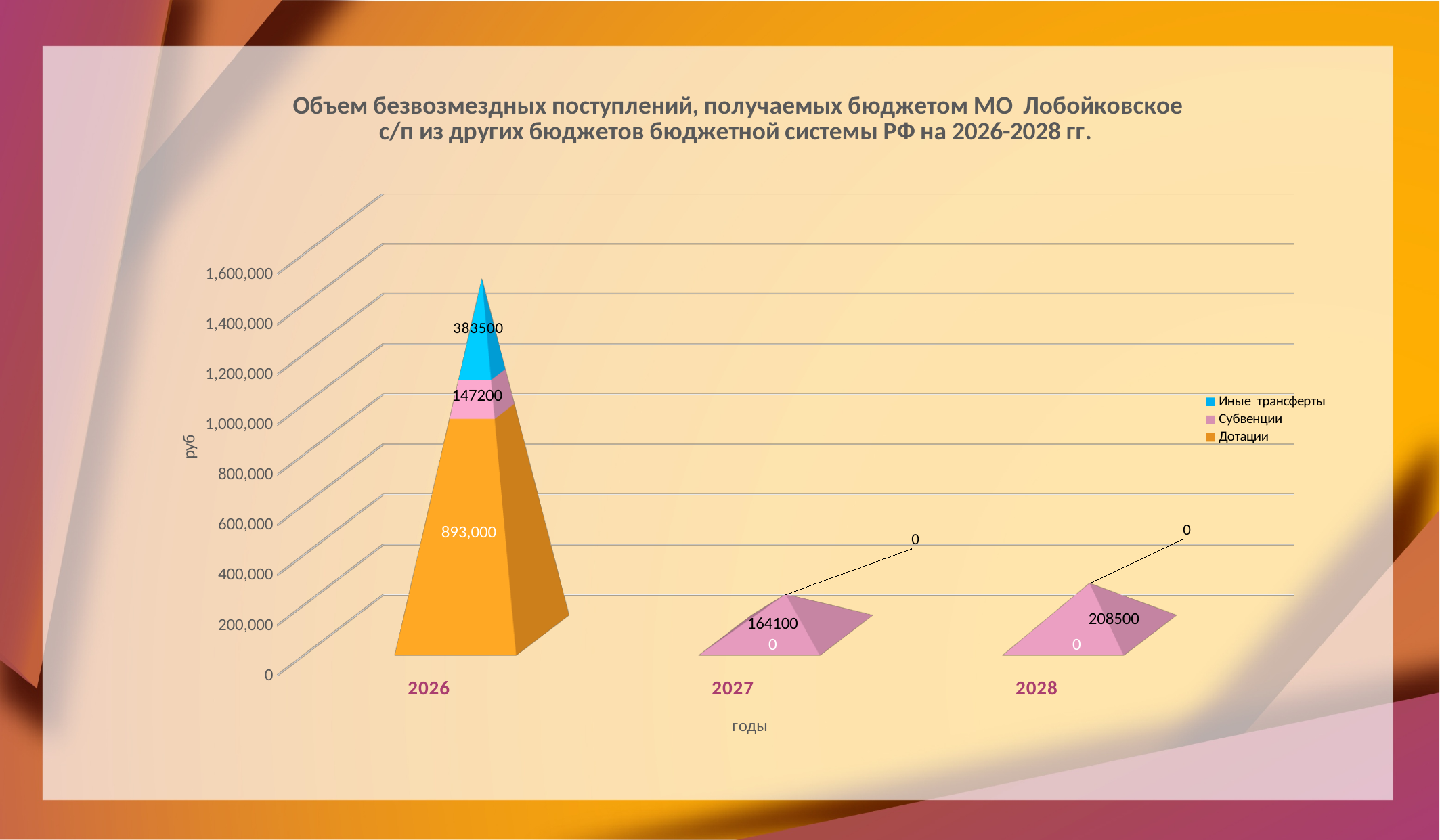
What is the value of Субвенции for 2027? 164100 What is the difference between the Субвенции values for 2028 and 2027? 44400 What is the value of Иные трансферты for 2026? 383500 What is the total of all series for 2026? 1,423,700 What is the value of Дотации for 2027? 0 Which is larger in 2026: Дотации or Иные трансферты? Дотации What kind of chart is shown on the slide? Stacked bar chart Which year has the lowest total of all series? 2027 How many series does the legend list? 3 What is the value of Дотации for 2026? 893,000 Which year has the highest value for Субвенции? 2028 What is the value of Субвенции for 2028? 208500